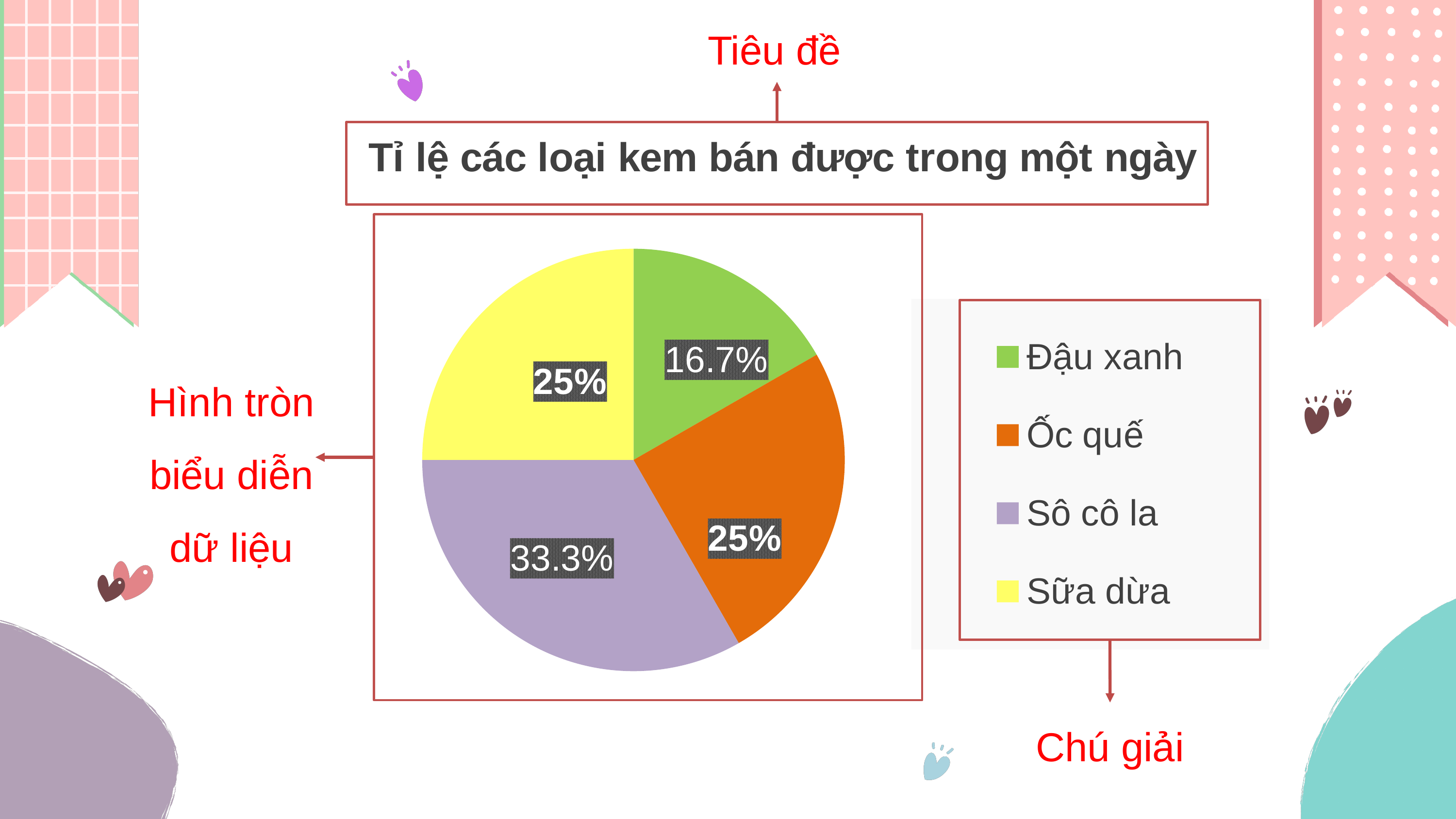
How many categories does the pie chart show? 4 Which is larger, the share of Ốc quế or the share of Đậu xanh? Ốc quế What is the difference between the shares of Sô cô la and Đậu xanh? 16.6% What kind of chart is shown on the slide? Pie chart What share of the pie does Sô cô la have? 33.3% What share of the pie does Đậu xanh have? 16.7% What share of the pie does Ốc quế have? 25% What is the title of the chart? Tỉ lệ các loại kem bán được trong một ngày Which ice cream type has the largest share? Sô cô la Which colour represents Sữa dừa in the legend? Yellow Which ice cream type has the smallest share? Đậu xanh